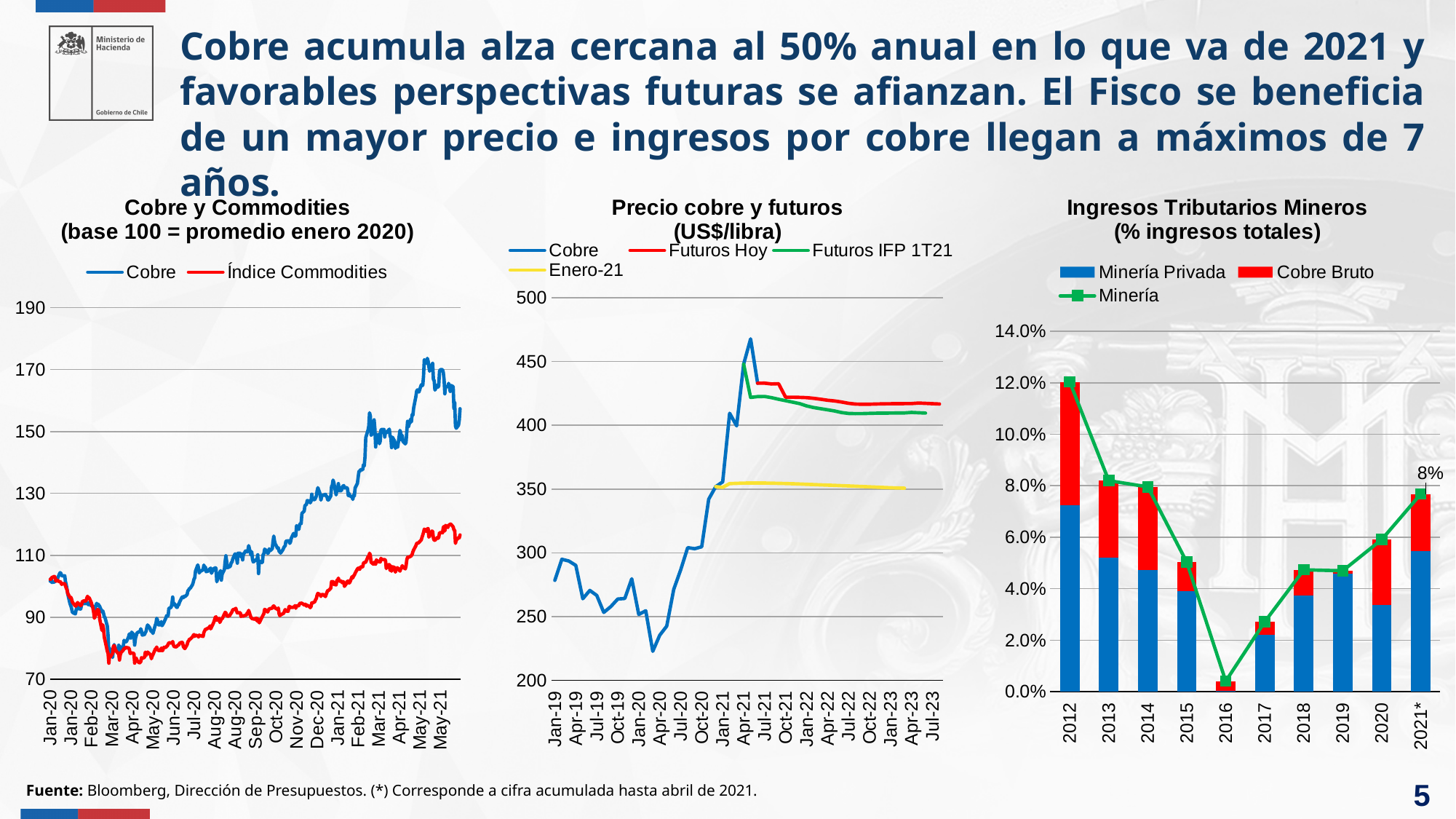
In the 'Cobre y Commodities' chart, does the Cobre series overall rise or fall from Jan-20 to May-21? rise In the 'Precio cobre y futuros (US$/libra)' chart, which series is drawn in yellow? Enero-21 In the 'Ingresos Tributarios Mineros' chart, which year has the highest Minería value? 2012 In the 'Ingresos Tributarios Mineros' chart, which year has the lowest Minería value? 2016 In the 'Ingresos Tributarios Mineros' chart, is the Minería value for 2012 greater or less than 10.0%? greater In the 'Ingresos Tributarios Mineros' chart, what value is labelled for 2021*? 8% How many series does the legend of the 'Precio cobre y futuros (US$/libra)' chart list? 4 In the 'Ingresos Tributarios Mineros' chart, which is larger, the Minería value for 2013 or for 2019? 2013 What kind of chart is 'Cobre y Commodities (base 100 = promedio enero 2020)'? line chart How many series does the legend of the 'Ingresos Tributarios Mineros (% ingresos totales)' chart list? 3 How many years are shown on the x axis of the 'Ingresos Tributarios Mineros' chart? 10 How many series does the legend of the 'Cobre y Commodities' chart list? 2